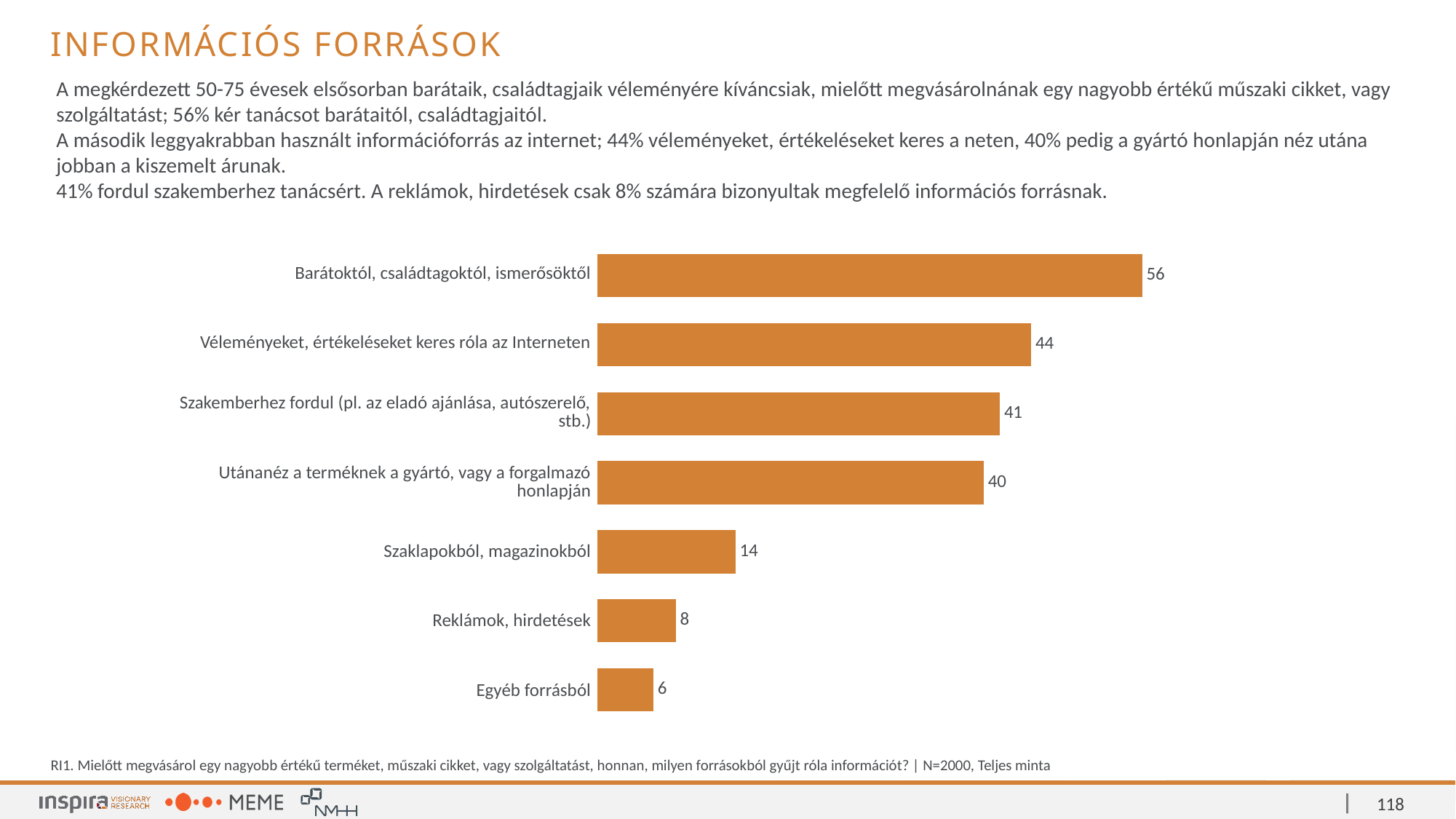
What is the value for "Barátoktól, családtagoktól, ismerősöktől"? 56 What is the value for "Utánanéz a terméknek a gyártó, vagy a forgalmazó honlapján"? 40 What kind of chart is shown on the slide? Bar chart Which category has the highest value? Barátoktól, családtagoktól, ismerősöktől What is the difference between the values for "Szaklapokból, magazinokból" and "Reklámok, hirdetések"? 6 How many categories are shown in the chart? 7 Which is larger: the value for "Véleményeket, értékeléseket keres róla az Interneten" or for "Szakemberhez fordul (pl. az eladó ajánlása, autószerelő, stb.)"? Véleményeket, értékeléseket keres róla az Interneten Which category has the lowest value? Egyéb forrásból What is the value for "Reklámok, hirdetések"? 8 What colour are the bars in the chart? Orange What is the value for "Szaklapokból, magazinokból"? 14 What is the difference between the values for "Barátoktól, családtagoktól, ismerősöktől" and "Véleményeket, értékeléseket keres róla az Interneten"? 12